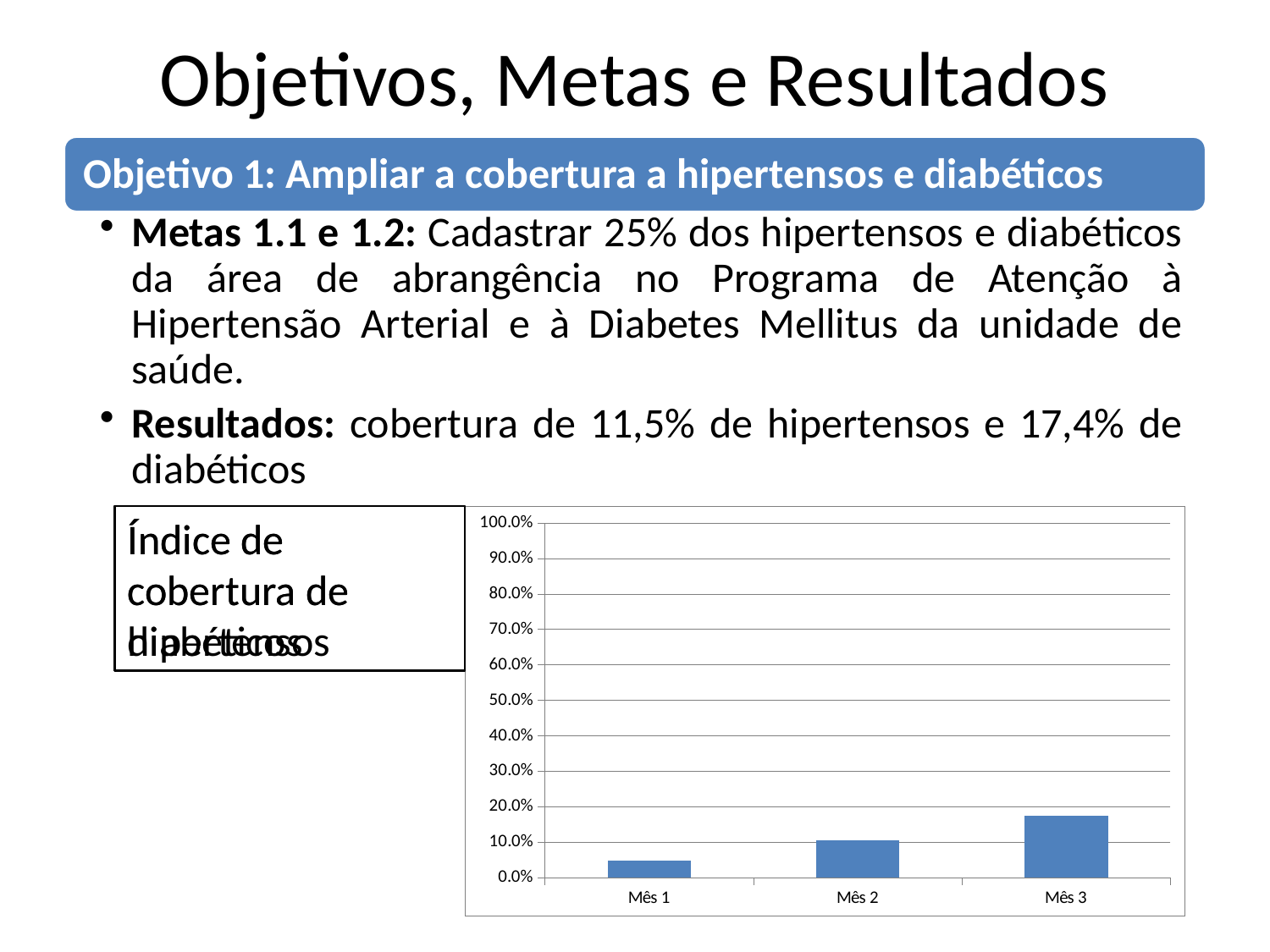
Do the values rise or fall from Mês 1 to Mês 3? rise How many categories are shown on the x axis of the chart? 3 Which month has the lowest bar in the chart? Mês 1 Which month has the highest bar in the chart? Mês 3 Is the value for Mês 3 greater or less than 20.0%? less What kind of chart is shown on the slide? bar chart Is the value for Mês 1 greater or less than 10.0%? less Which is larger, the value for Mês 1 or the value for Mês 3? Mês 3 Is the value for Mês 3 greater or less than 10.0%? greater What is the highest value shown on the y axis of the chart? 100.0% Which is larger, the value for Mês 2 or the value for Mês 3? Mês 3